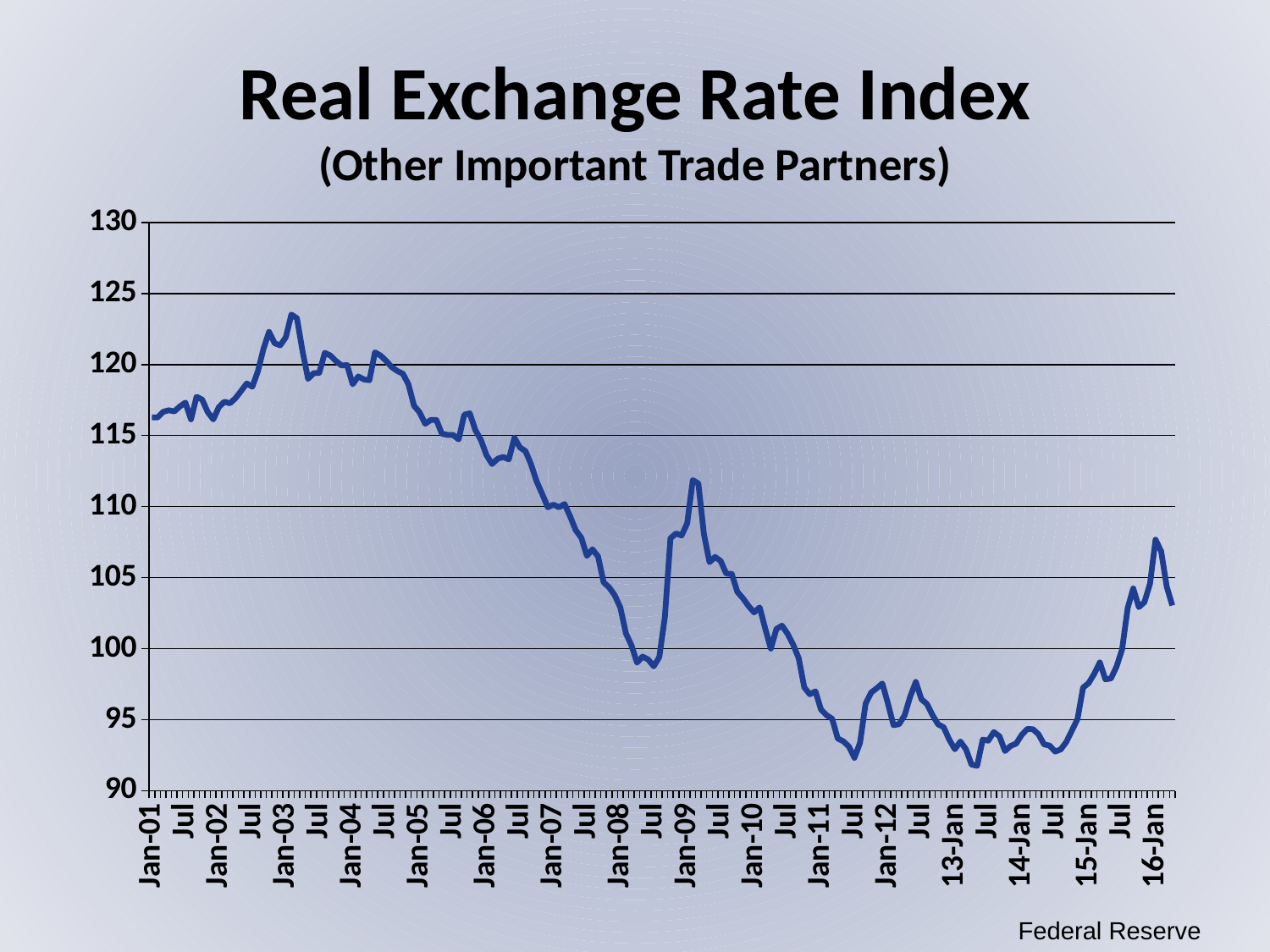
Is the value for Jul-08 greater or less than 100? less What kind of chart is shown on the slide? line chart Is the value for Jan-03 greater or less than 120? greater Is the value for Jan-12 greater or less than 100? less Does the index rise or fall between Jan-14 and 16-Jan? rise Does the index rise or fall between Jan-03 and Jan-08? fall What source is cited for the chart? Federal Reserve What is the title of the chart? Real Exchange Rate Index (Other Important Trade Partners)